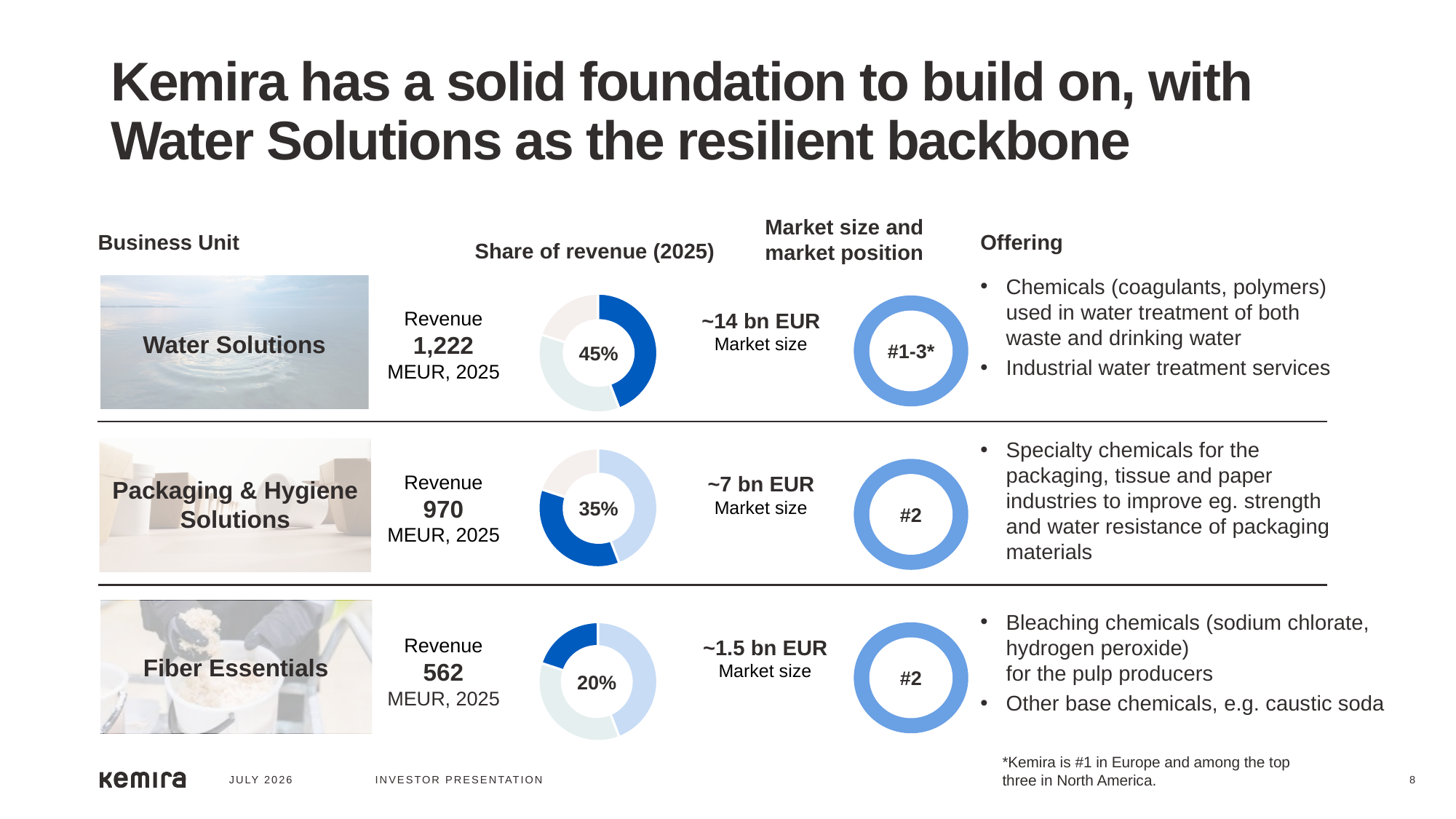
In the Share of revenue (2025) donut charts, which has the larger share of revenue: Packaging & Hygiene Solutions or Fiber Essentials? Packaging & Hygiene Solutions What kind of chart is used to show the share of revenue for each business unit? Donut chart Which year do the Share of revenue donut charts refer to? 2025 According to the Share of revenue (2025) donut charts, which business unit has the smallest share of revenue? Fiber Essentials In the Share of revenue (2025) donut charts, what share of revenue does Packaging & Hygiene Solutions account for? 35% How many Share of revenue (2025) donut charts are shown on the slide? 3 What do the three business unit shares in the Share of revenue (2025) donut charts add up to? 100% In the Share of revenue (2025) donut charts, what share of revenue does Fiber Essentials account for? 20% In the Share of revenue (2025) donut charts, what share of revenue does Water Solutions account for? 45% What is the 2025 revenue shown next to the Water Solutions donut chart? 1,222 MEUR In the Share of revenue (2025) donut charts, how many percentage points higher is Water Solutions' share than Fiber Essentials' share? 25 percentage points According to the Share of revenue (2025) donut charts, which business unit has the largest share of revenue? Water Solutions